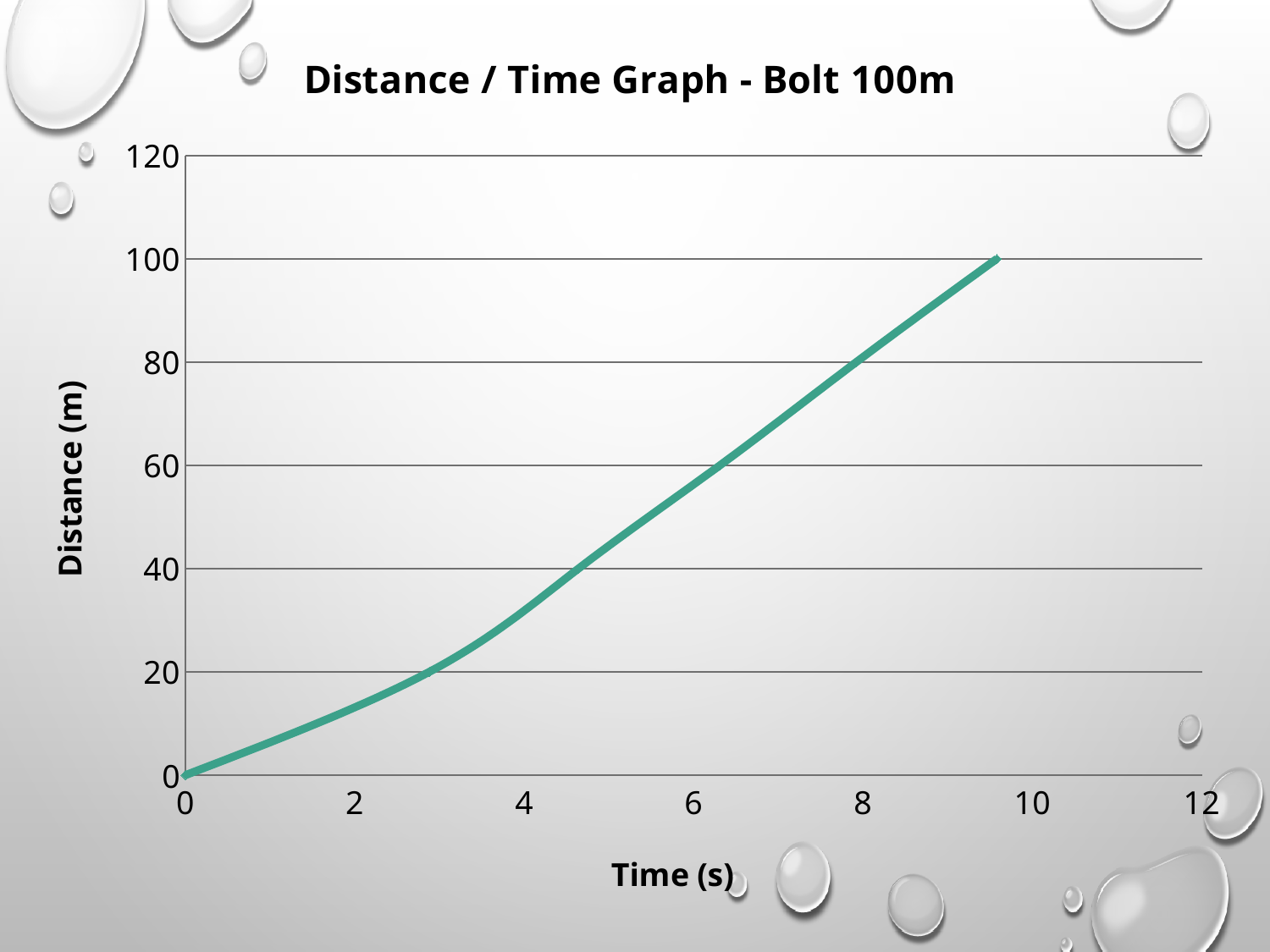
Is the distance at 9 s greater or less than 80? greater Does the distance rise or fall as time increases along the x axis? rise What is the title of the chart? Distance / Time Graph - Bolt 100m What is the highest value shown on the vertical axis? 120 What is the distance at time 0 s? 0 Is the distance at 2 s greater or less than 20? less What is the highest distance value reached by the line? 100 Is the distance at 5 s greater or less than 40? greater What kind of chart is shown on the slide? line chart What is the label of the vertical axis? Distance (m) Which is larger, the distance at 3 s or the distance at 7 s? 7 s